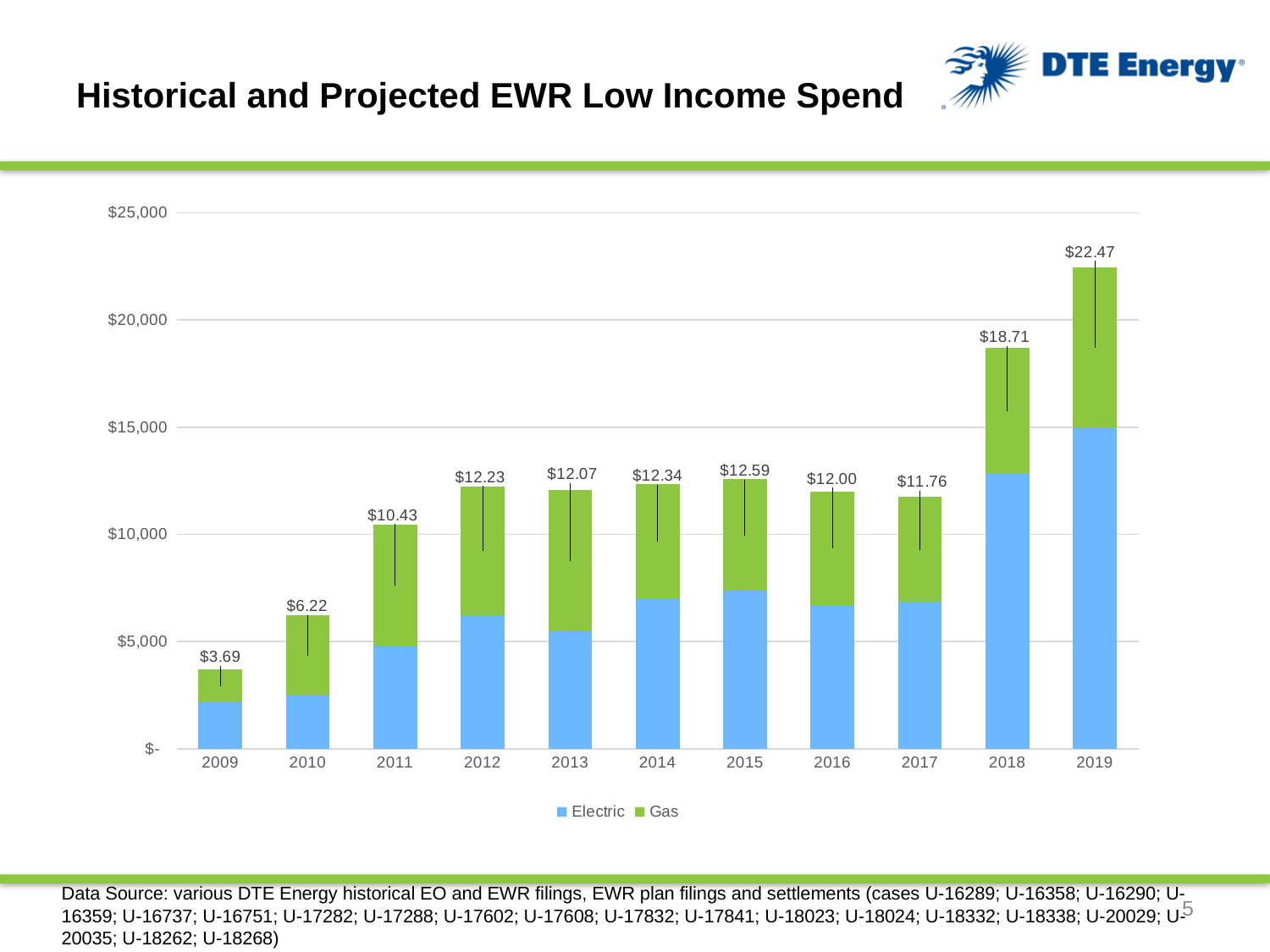
Which year has the highest labeled total? 2019 What is the data label shown on the bar for 2019? $22.47 What is the data label shown on the bar for 2009? $3.69 How many series does the legend list? 2 What kind of chart is shown on the slide? Stacked bar chart Do the labeled totals rise or fall from 2009 to 2012? rise Is the Electric value for 2019 greater or less than $10,000? greater How many years are shown on the x axis? 11 What are the two series named in the legend? Electric and Gas Which year has the lowest labeled total? 2009 Which year has the larger labeled total, 2014 or 2015? 2015 What is the difference between the labeled totals for 2019 and 2018? $3.76